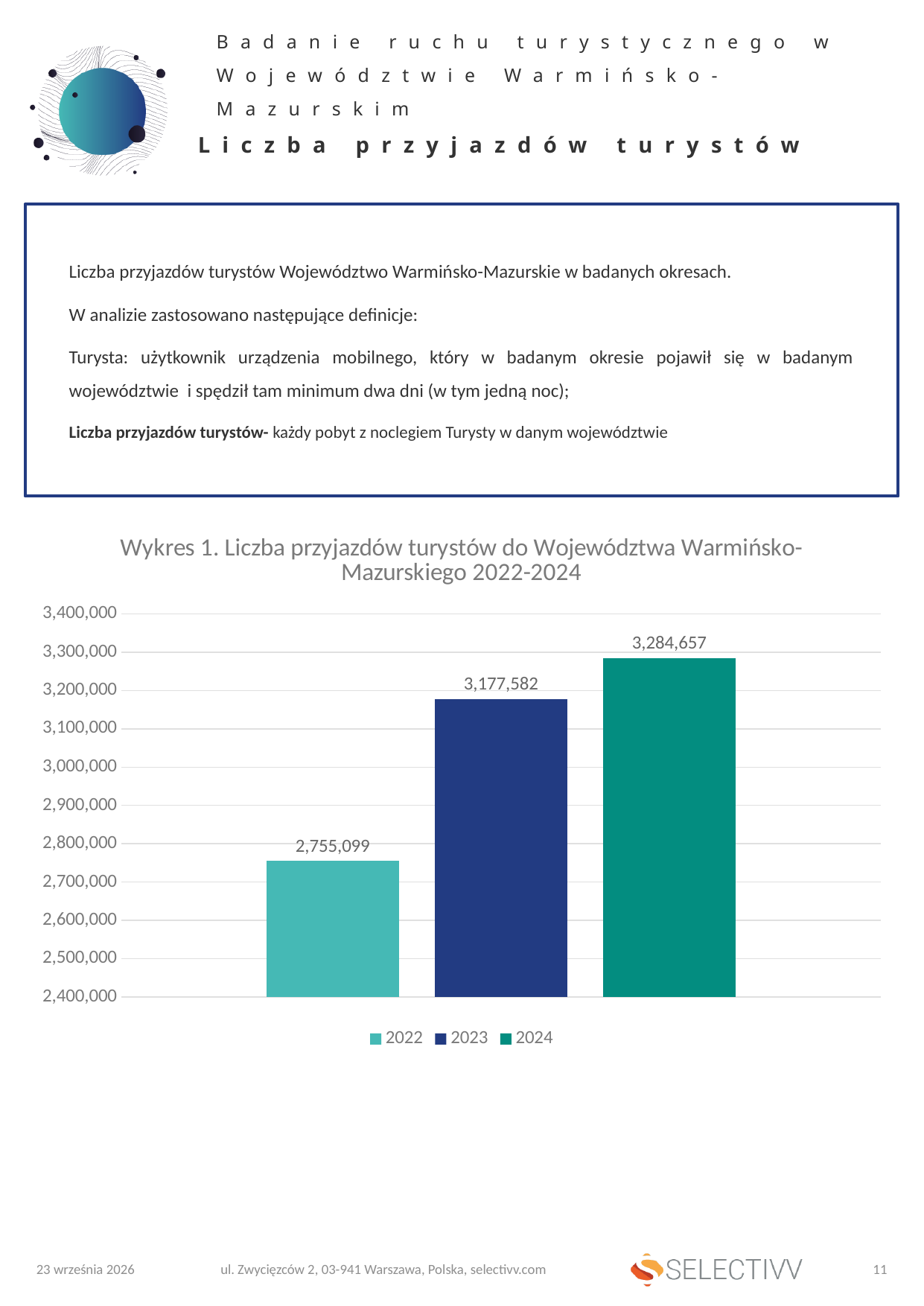
What is the number of tourist arrivals shown for 2024? 3,284,657 What is the number of tourist arrivals shown for 2023? 3,177,582 What is the difference in tourist arrivals between 2023 and 2022? 422,483 What is the difference in tourist arrivals between 2024 and 2023? 107,075 What is the number of tourist arrivals shown for 2022? 2,755,099 Which year has the highest number of tourist arrivals? 2024 Is the value for 2022 greater or less than 2,800,000? less Which year has the lowest number of tourist arrivals? 2022 Which year has more tourist arrivals, 2022 or 2023? 2023 How many bars are shown in the chart? 3 What kind of chart is shown on the slide? bar chart Do the values rise or fall from 2022 to 2024? rise